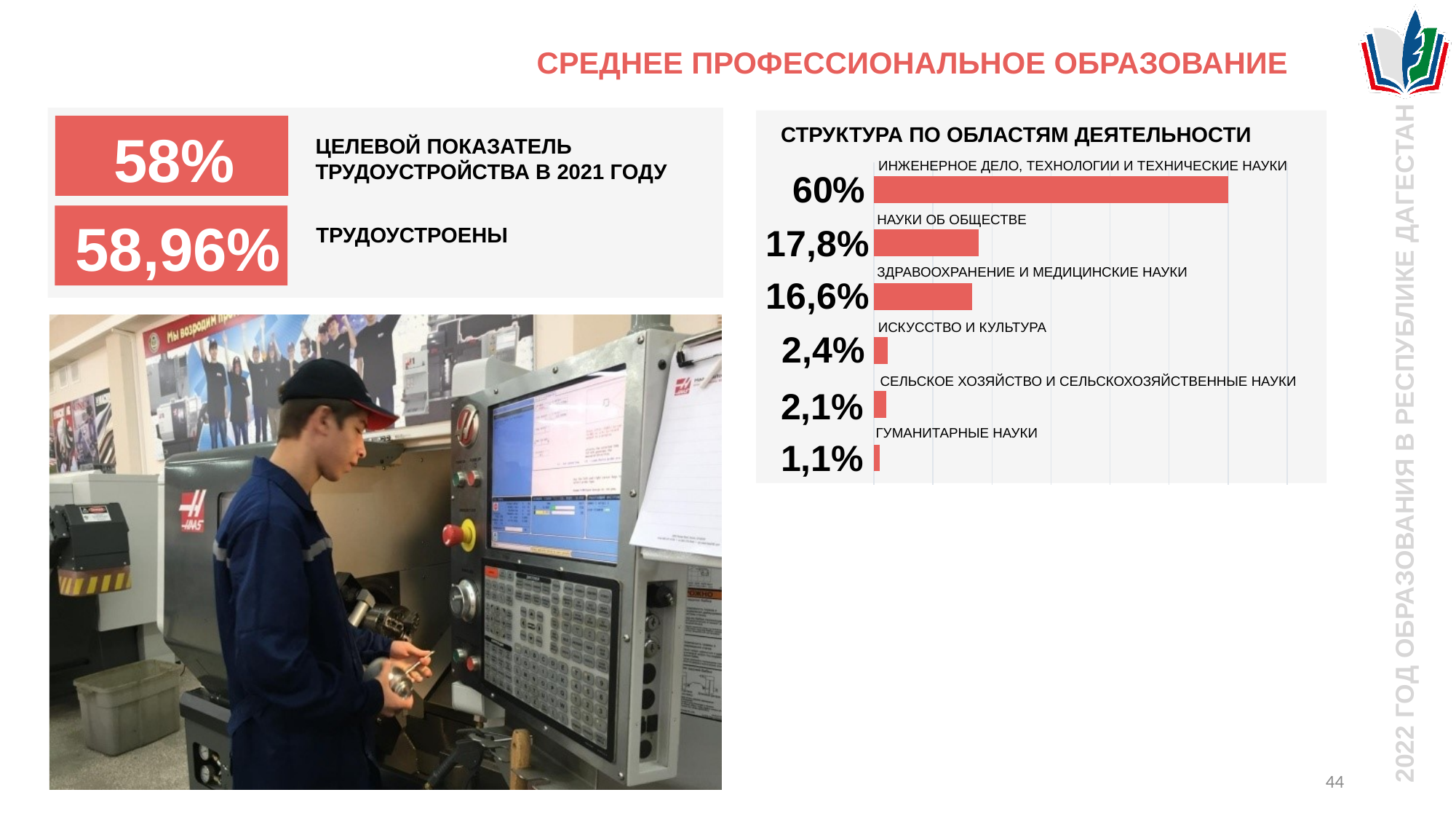
How many categories are shown in the chart СТРУКТУРА ПО ОБЛАСТЯМ ДЕЯТЕЛЬНОСТИ? 6 What is the value for ГУМАНИТАРНЫЕ НАУКИ in the chart? 1,1% What is the value for НАУКИ ОБ ОБЩЕСТВЕ in the chart СТРУКТУРА ПО ОБЛАСТЯМ ДЕЯТЕЛЬНОСТИ? 17,8% What kind of chart is СТРУКТУРА ПО ОБЛАСТЯМ ДЕЯТЕЛЬНОСТИ? Bar chart What is the value for ИНЖЕНЕРНОЕ ДЕЛО, ТЕХНОЛОГИИ И ТЕХНИЧЕСКИЕ НАУКИ in the chart СТРУКТУРА ПО ОБЛАСТЯМ ДЕЯТЕЛЬНОСТИ? 60% What is the title of the chart on the right side of the slide? СТРУКТУРА ПО ОБЛАСТЯМ ДЕЯТЕЛЬНОСТИ What is the difference between the values for ИНЖЕНЕРНОЕ ДЕЛО, ТЕХНОЛОГИИ И ТЕХНИЧЕСКИЕ НАУКИ and НАУКИ ОБ ОБЩЕСТВЕ? 42,2% What is the value for ЗДРАВООХРАНЕНИЕ И МЕДИЦИНСКИЕ НАУКИ in the chart? 16,6% What is the difference between the values for НАУКИ ОБ ОБЩЕСТВЕ and ЗДРАВООХРАНЕНИЕ И МЕДИЦИНСКИЕ НАУКИ? 1,2% Which category has the highest value in the chart СТРУКТУРА ПО ОБЛАСТЯМ ДЕЯТЕЛЬНОСТИ? ИНЖЕНЕРНОЕ ДЕЛО, ТЕХНОЛОГИИ И ТЕХНИЧЕСКИЕ НАУКИ Which category has the lowest value in the chart СТРУКТУРА ПО ОБЛАСТЯМ ДЕЯТЕЛЬНОСТИ? ГУМАНИТАРНЫЕ НАУКИ Which is larger in the chart: the value for ИСКУССТВО И КУЛЬТУРА or the value for СЕЛЬСКОЕ ХОЗЯЙСТВО И СЕЛЬСКОХОЗЯЙСТВЕННЫЕ НАУКИ? ИСКУССТВО И КУЛЬТУРА